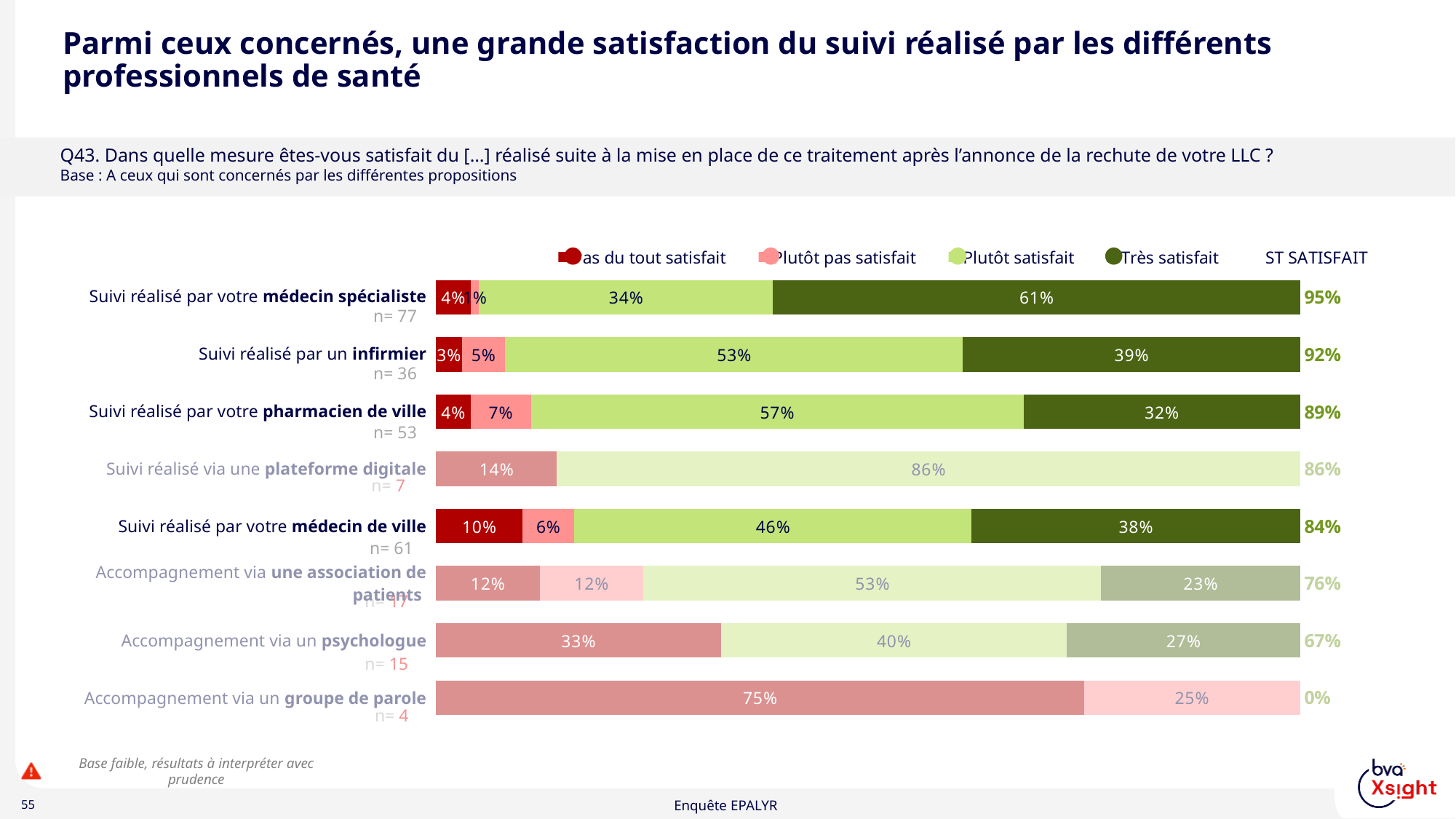
Which has a larger 'Très satisfait' value: 'Suivi réalisé par un infirmier' or 'Suivi réalisé par votre pharmacien de ville'? Suivi réalisé par un infirmier What kind of chart is shown on the slide? Stacked bar chart What is the 'Très satisfait' value for 'Suivi réalisé par votre médecin spécialiste'? 61% What is the difference between the ST SATISFAIT values for 'Suivi réalisé par un infirmier' and 'Suivi réalisé par votre médecin de ville'? 8% Which category has the lowest ST SATISFAIT value? Accompagnement via un groupe de parole What is the 'Plutôt satisfait' value for 'Suivi réalisé par un infirmier'? 53% What is the ST SATISFAIT value for 'Suivi réalisé par votre pharmacien de ville'? 89% Which category has the highest ST SATISFAIT value? Suivi réalisé par votre médecin spécialiste How many series does the legend list? 4 What is the sample size (n) shown for 'Suivi réalisé par votre médecin spécialiste'? n= 77 What is the 'Pas du tout satisfait' value for 'Suivi réalisé par votre médecin de ville'? 10% How many categories (types of suivi/accompagnement) are plotted in the chart? 8